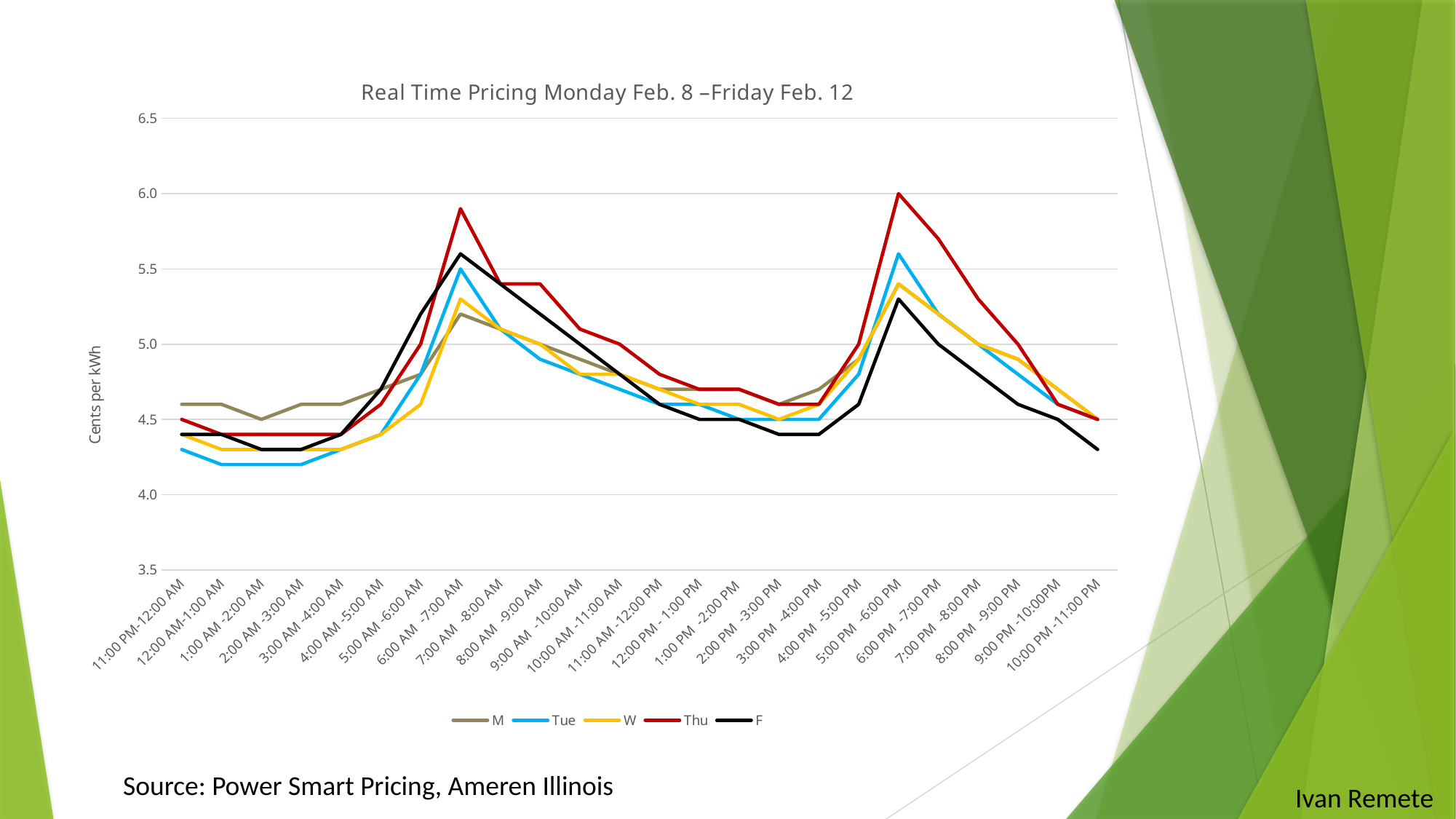
What is the label on the vertical axis? Cents per kWh What is the title of the chart? Real Time Pricing Monday Feb. 8 –Friday Feb. 12 Is the value for F at 10:00 PM -11:00 PM greater or less than 4.5? less What is the value for Tue at 6:00 AM -7:00 AM? 5.5 What kind of chart is shown on the slide? line chart Which series reaches the highest value anywhere on the chart? Thu How many series does the legend list? 5 At 6:00 PM -7:00 PM, which is larger, the value for Thu or the value for F? Thu Do the values for Thu rise or fall from 6:00 PM -7:00 PM to 10:00 PM -11:00 PM? fall How many hourly time periods are shown on the x axis? 24 Is the value for Thu at 6:00 AM -7:00 AM greater or less than 5.5? greater